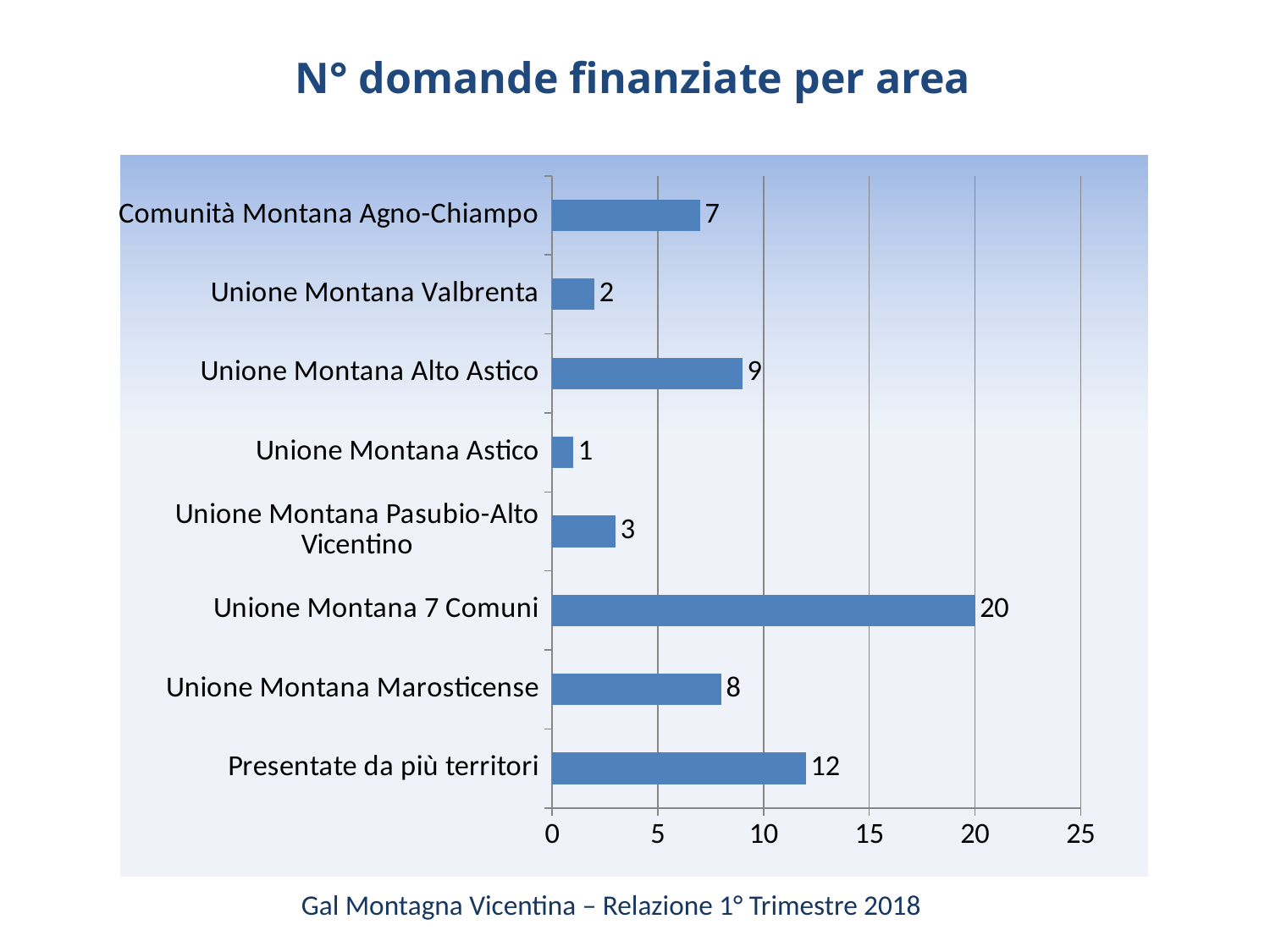
What is the value for Unione Montana 7 Comuni? 20 What is the value for Comunità Montana Agno-Chiampo? 7 How many categories are shown in the chart? 8 Is the value for Unione Montana 7 Comuni greater or less than 15? greater Which is larger, the value for Unione Montana Marosticense or the value for Comunità Montana Agno-Chiampo? Unione Montana Marosticense What is the title of the chart? N° domande finanziate per area What kind of chart is shown on the slide? bar chart What is the difference between the values for Unione Montana 7 Comuni and Presentate da più territori? 8 Which category has the lowest value? Unione Montana Astico What is the value for Presentate da più territori? 12 Which category has the highest value? Unione Montana 7 Comuni What is the difference between the values for Unione Montana Alto Astico and Unione Montana Valbrenta? 7